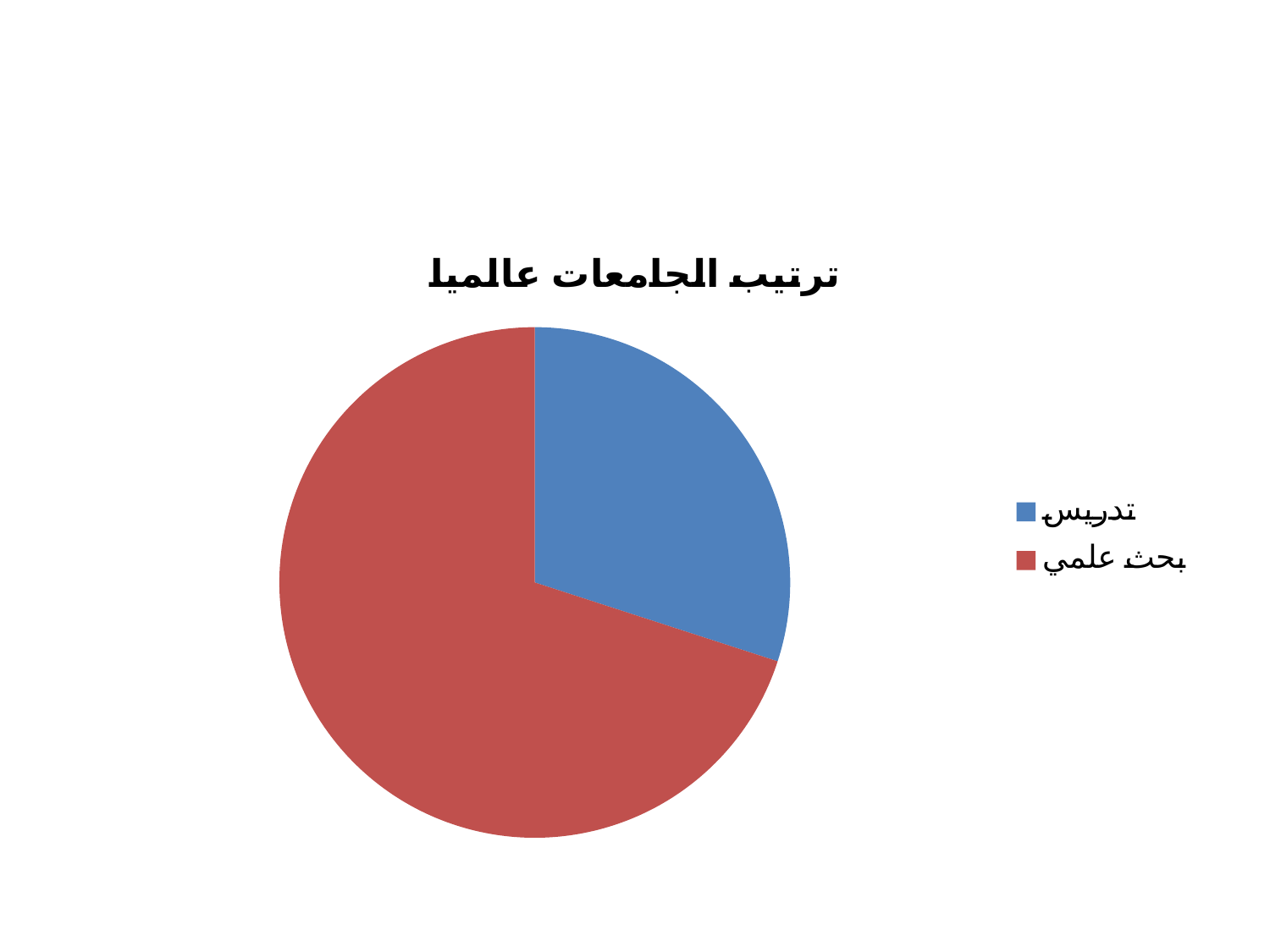
How many entries does the legend list? 2 How many slices does the pie chart have? 2 What colour is the slice for بحث علمي? Red What is the title of the chart? ترتيب الجامعات عالميا Which slice is larger, تدريس or بحث علمي? بحث علمي What kind of chart is shown on the slide? Pie chart Which category has the largest slice of the pie? بحث علمي Which category has the smallest slice of the pie? تدريس